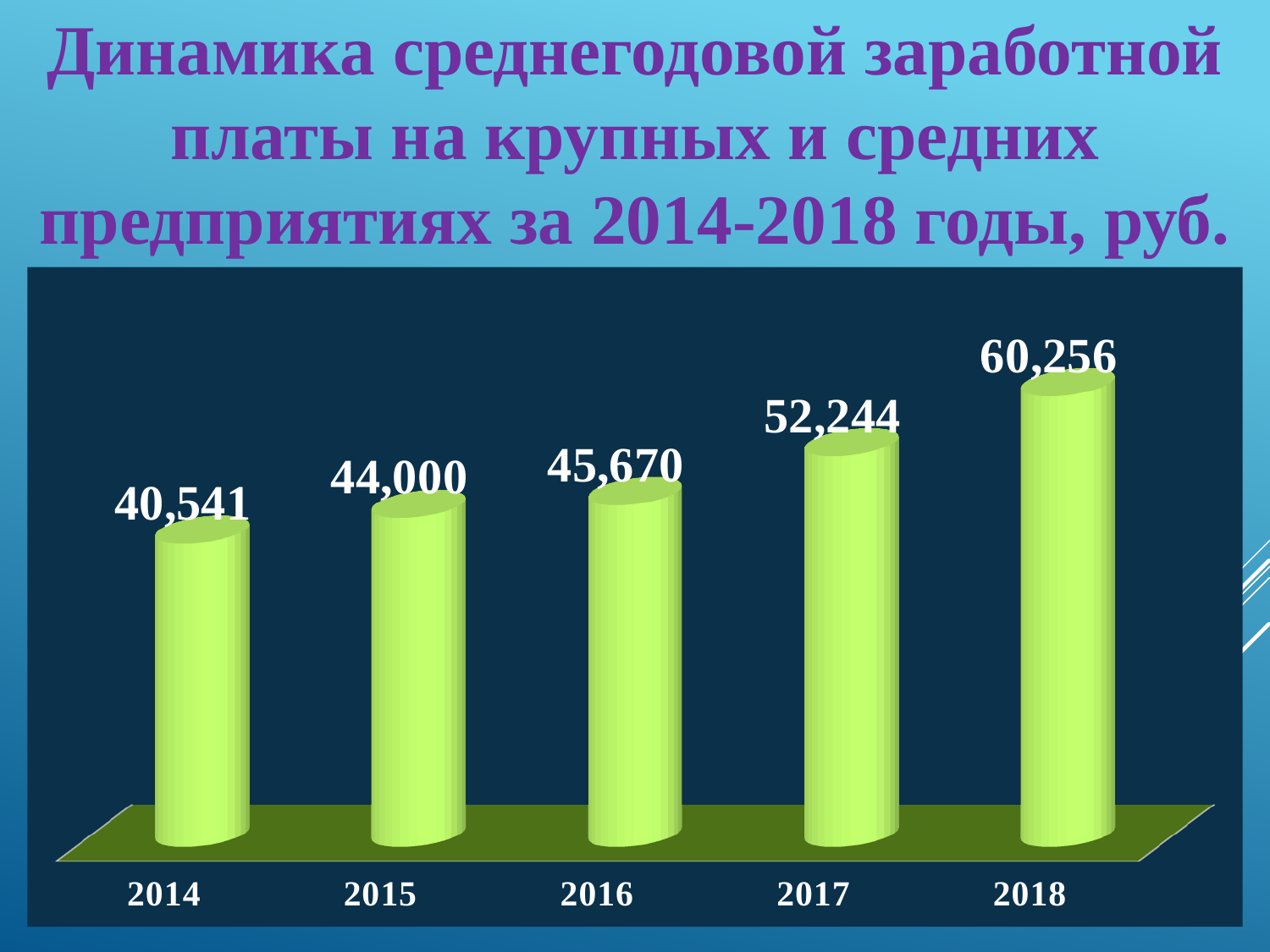
What is the value for 2016? 45,670 Which is larger, the value for 2016 or the value for 2017? 2017 Which year has the highest value? 2018 How many years are shown on the chart? 5 What is the difference between the values for 2015 and 2014? 3,459 What is the difference between the values for 2018 and 2017? 8,012 What is the value for 2014? 40,541 Do the values rise or fall from 2014 to 2018? rise What kind of chart is shown on the slide? bar chart Which year has the lowest value? 2014 What colour are the bars on the chart? green What is the value for 2018? 60,256